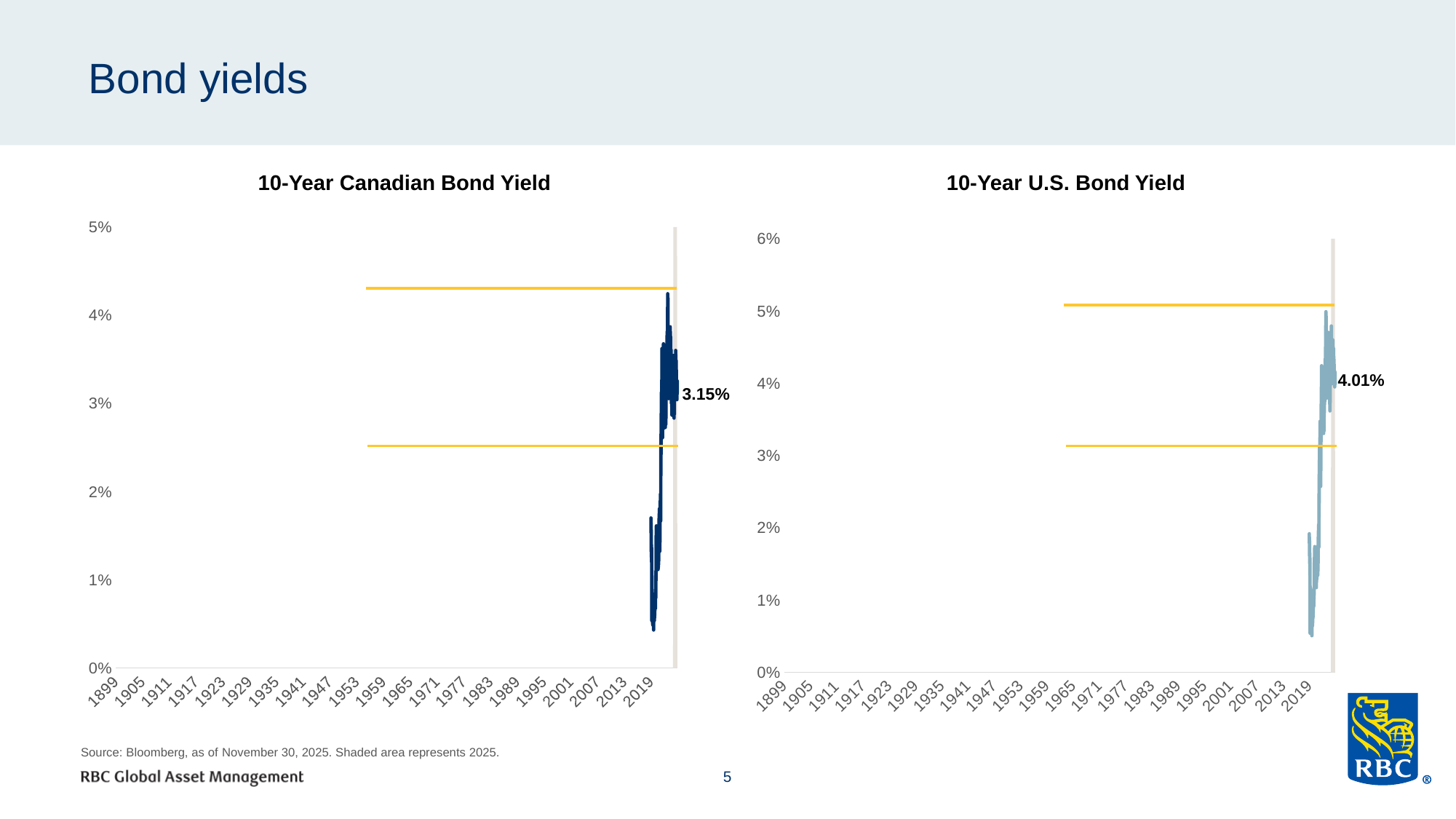
How many year labels are shown along the x axis of the 10-Year U.S. Bond Yield chart? 21 On the 10-Year Canadian Bond Yield chart, is the lowest point of the line greater or less than 1%? less What is the highest value shown on the y axis of the 10-Year U.S. Bond Yield chart? 6% What is the difference between the labelled latest U.S. yield (4.01%) and the labelled latest Canadian yield (3.15%)? 0.86% What kind of chart is the 10-Year Canadian Bond Yield chart? Line chart On the 10-Year Canadian Bond Yield chart, is the highest point of the line greater or less than 4%? greater Comparing the labelled latest values, which chart shows the higher 10-year bond yield, the Canadian or the U.S. chart? 10-Year U.S. Bond Yield On the 10-Year U.S. Bond Yield chart, what is the latest yield value labelled at the end of the line? 4.01% On the 10-Year Canadian Bond Yield chart, what is the latest yield value labelled at the end of the line? 3.15% On the 10-Year U.S. Bond Yield chart, is the highest point of the line greater or less than 4%? greater According to the note below the charts, what does the shaded area represent? 2025